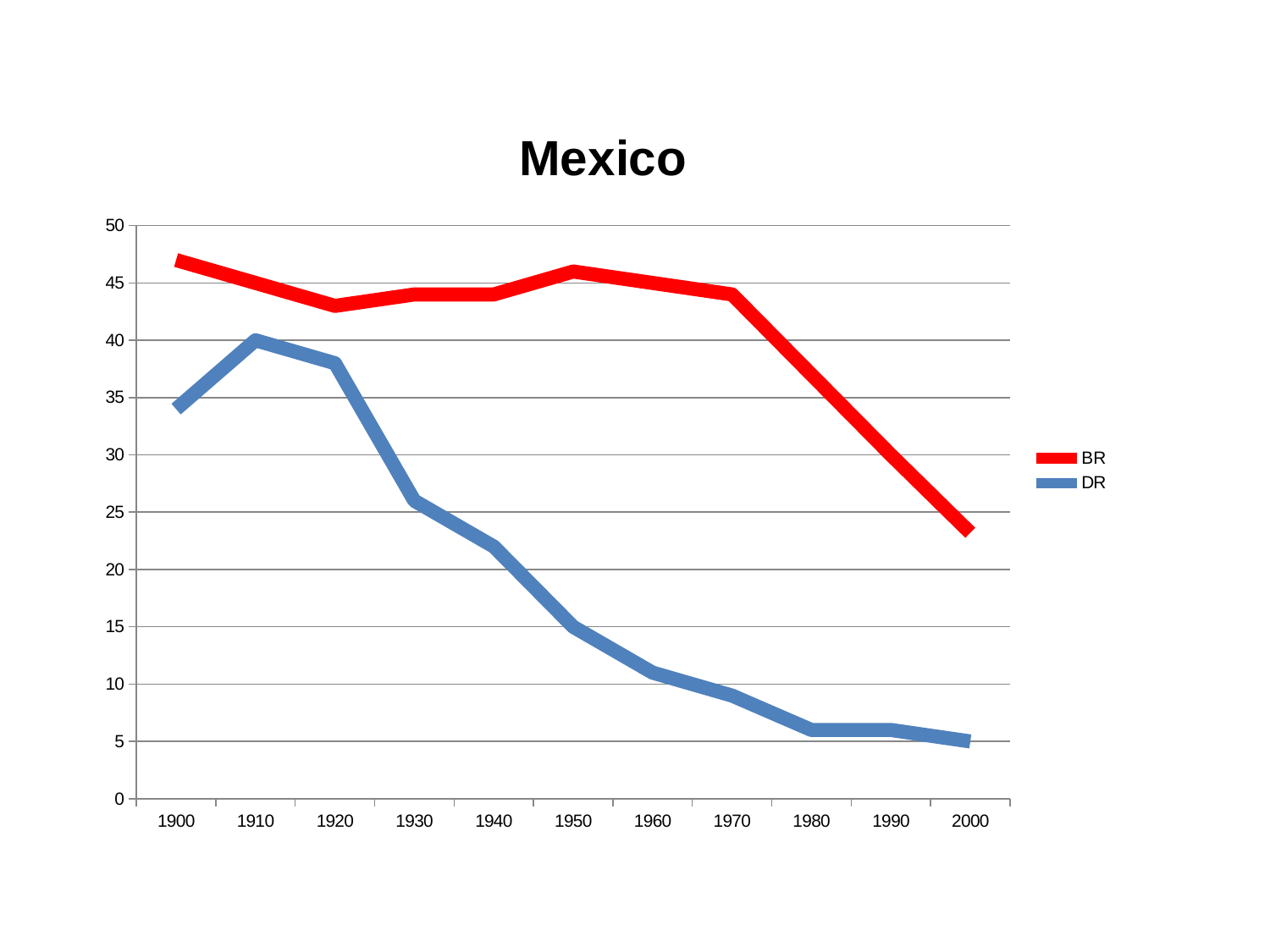
In which year does the BR series reach its lowest value? 2000 What is the title of the chart? Mexico What kind of chart is shown on the slide? line chart Which series has the higher value in 1950, BR or DR? BR Does the DR series rise or fall between 1910 and 2000? fall Is the BR value for 1900 greater or less than 45? greater How many years are plotted along the x axis? 11 Is the DR value for 1980 greater or less than 10? less How many series does the legend list? 2 Is the DR value for 1920 greater or less than 35? greater In which year does the DR series reach its highest value? 1910